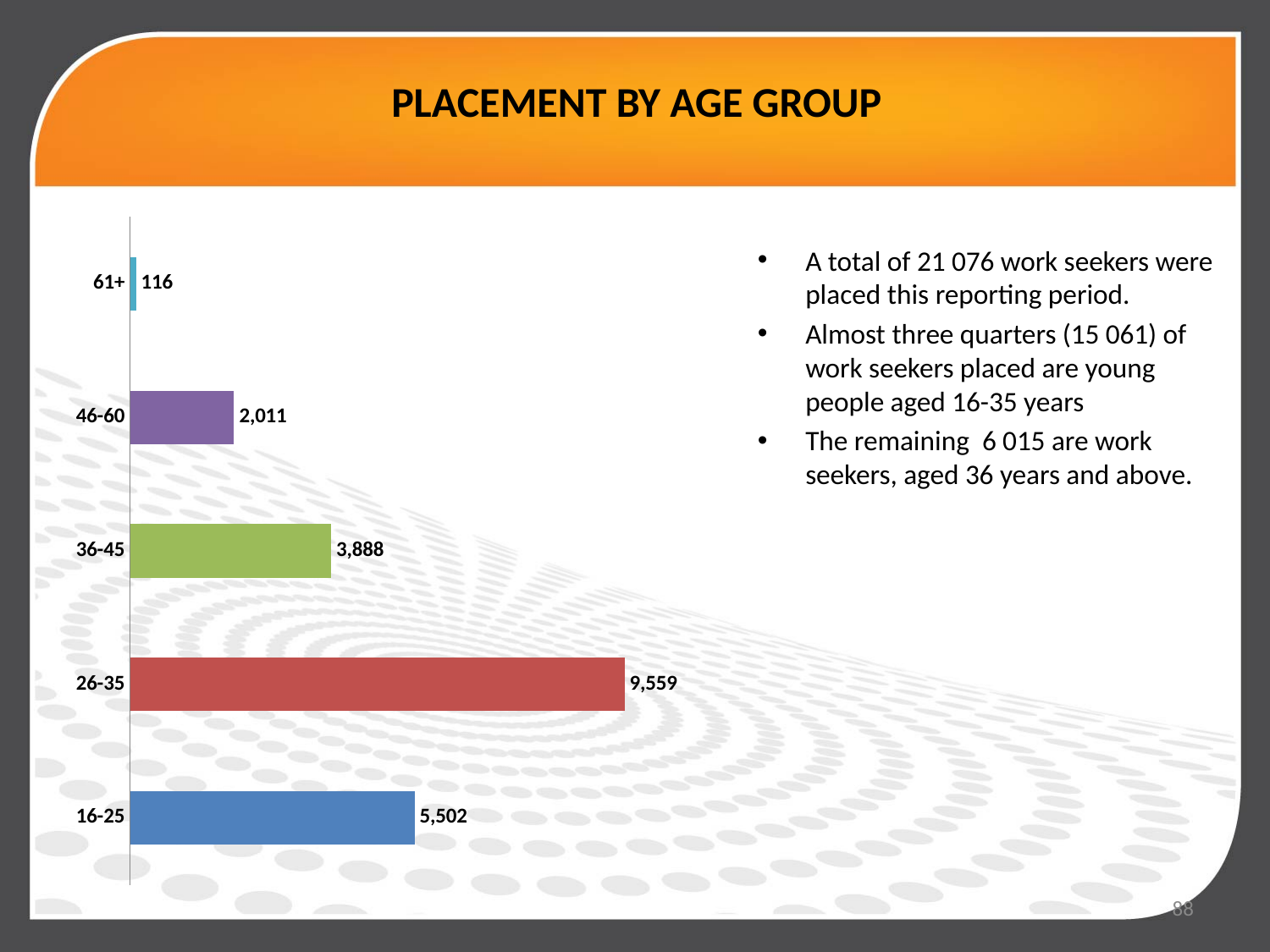
What is the difference between the placement values for the 26-35 and 16-25 age groups? 4,057 Which age group has the highest placement value? 26-35 What is the placement value for the 26-35 age group? 9,559 What is the placement value for the 46-60 age group? 2,011 Which age group has the lowest placement value? 61+ How many age groups are shown in the chart? 5 What is the difference between the placement values for the 36-45 and 46-60 age groups? 1,877 What is the placement value for the 61+ age group? 116 What is the title of the slide containing the chart? PLACEMENT BY AGE GROUP What is the placement value for the 16-25 age group? 5,502 What type of chart is shown on the slide? Bar chart Which age group has a larger placement value, 36-45 or 46-60? 36-45